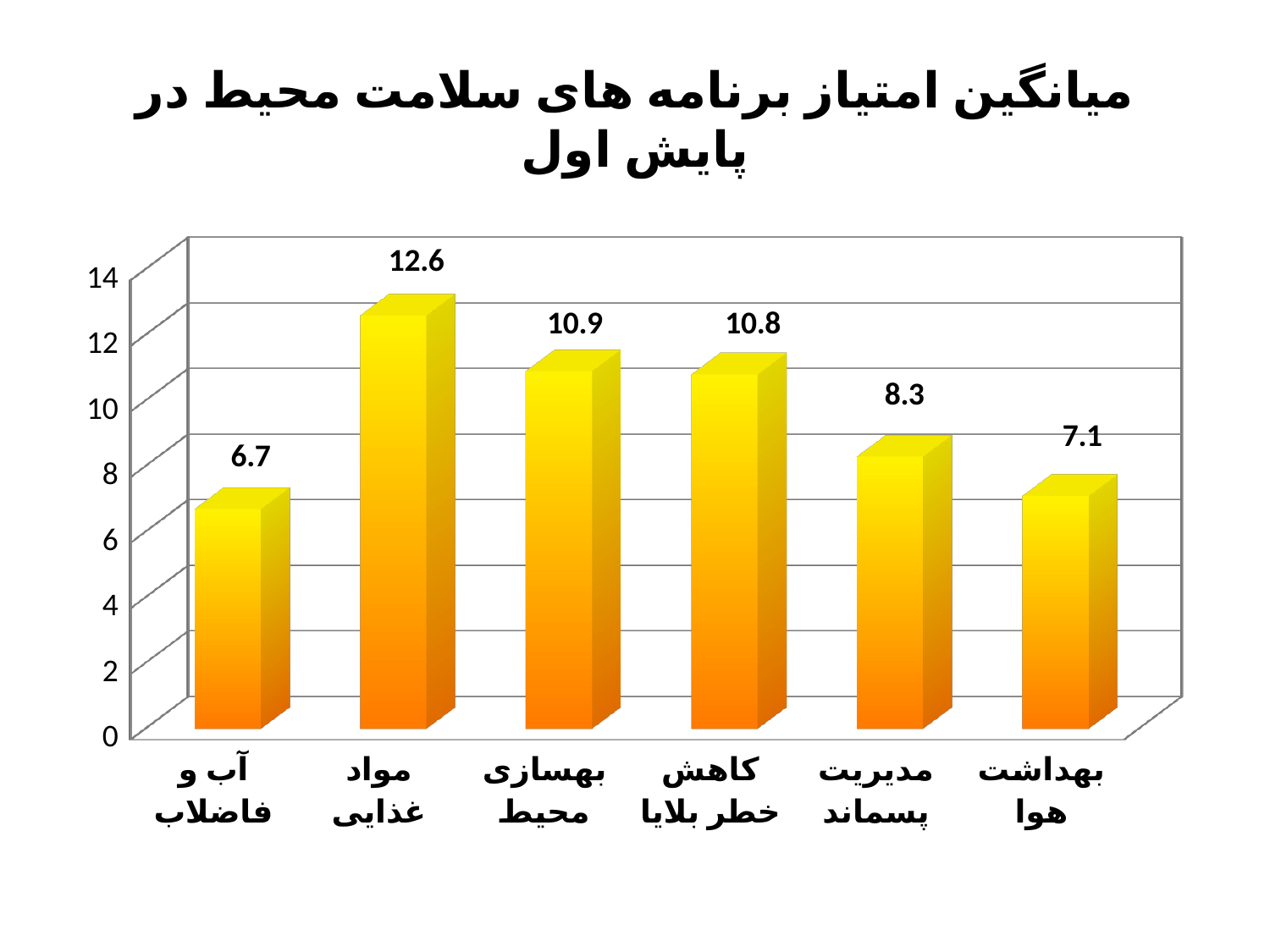
Which category has the highest value? مواد غذایی What is the value for مواد غذایی? 12.6 What is the difference between the values for بهسازی محیط and کاهش خطر بلایا? 0.1 Is the value for کاهش خطر بلایا greater or less than 10? greater What is the value for مدیریت پسماند? 8.3 Which category has the lowest value? آب و فاضلاب What kind of chart is shown on the slide? bar chart What is the difference between the values for مواد غذایی and آب و فاضلاب? 5.9 What is the value for بهداشت هوا? 7.1 How many categories are shown on the chart? 6 What is the value for آب و فاضلاب? 6.7 Which is larger, the value for مدیریت پسماند or the value for بهداشت هوا? مدیریت پسماند